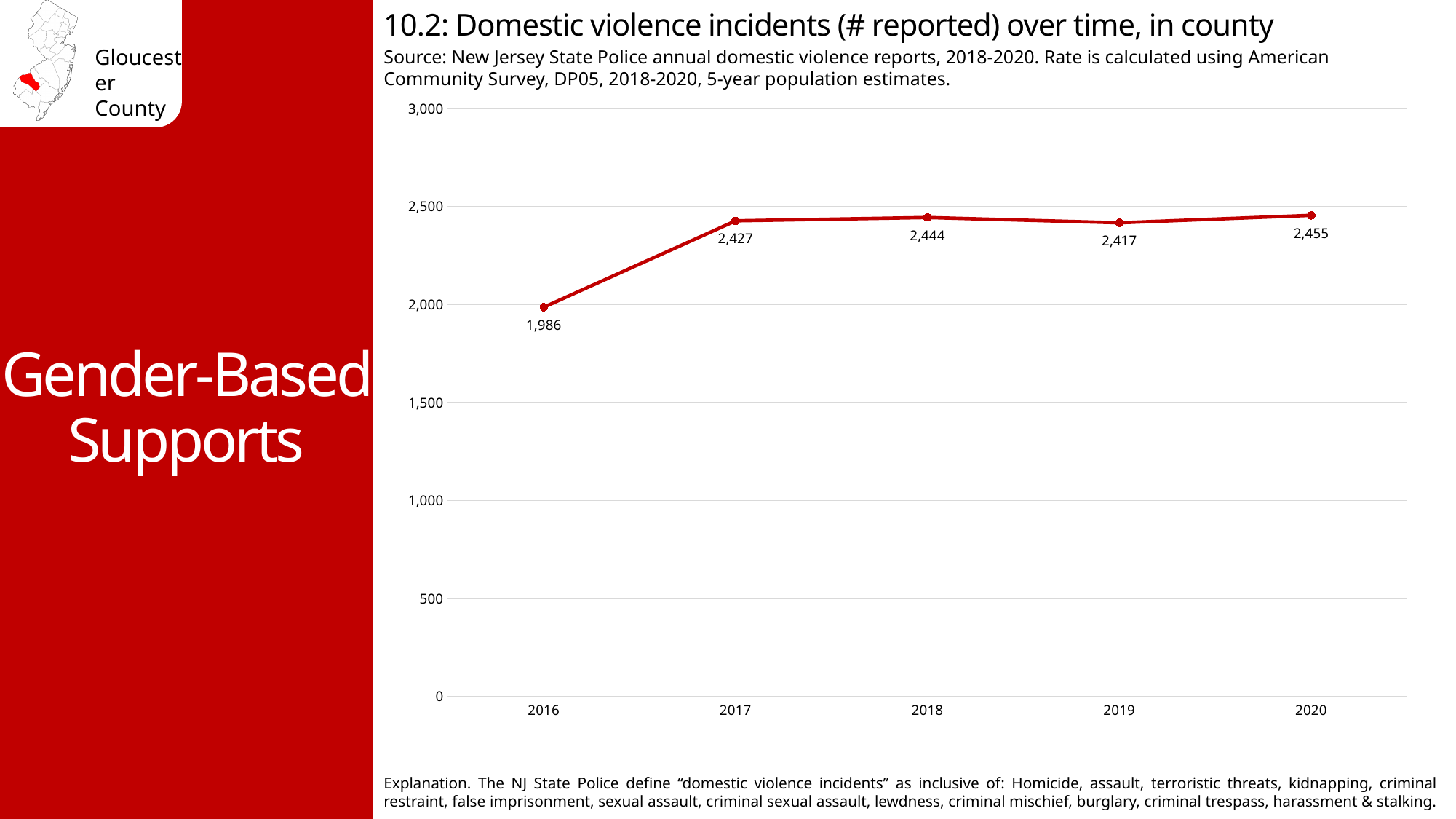
What is the difference in reported incidents between 2018 and 2019? 27 Which year had the lowest number of reported domestic violence incidents? 2016 Which year had more reported incidents, 2017 or 2019? 2017 Which year had the highest number of reported domestic violence incidents? 2020 What was the number of reported domestic violence incidents in 2020? 2,455 Did the number of reported incidents rise or fall from 2016 to 2017? rise What was the number of reported domestic violence incidents in 2016? 1,986 Is the value for 2016 greater or less than 2,000? less How many years are plotted on the chart? 5 What is the difference in reported incidents between 2017 and 2016? 441 What kind of chart is shown on the slide? line chart What was the number of reported domestic violence incidents in 2018? 2,444